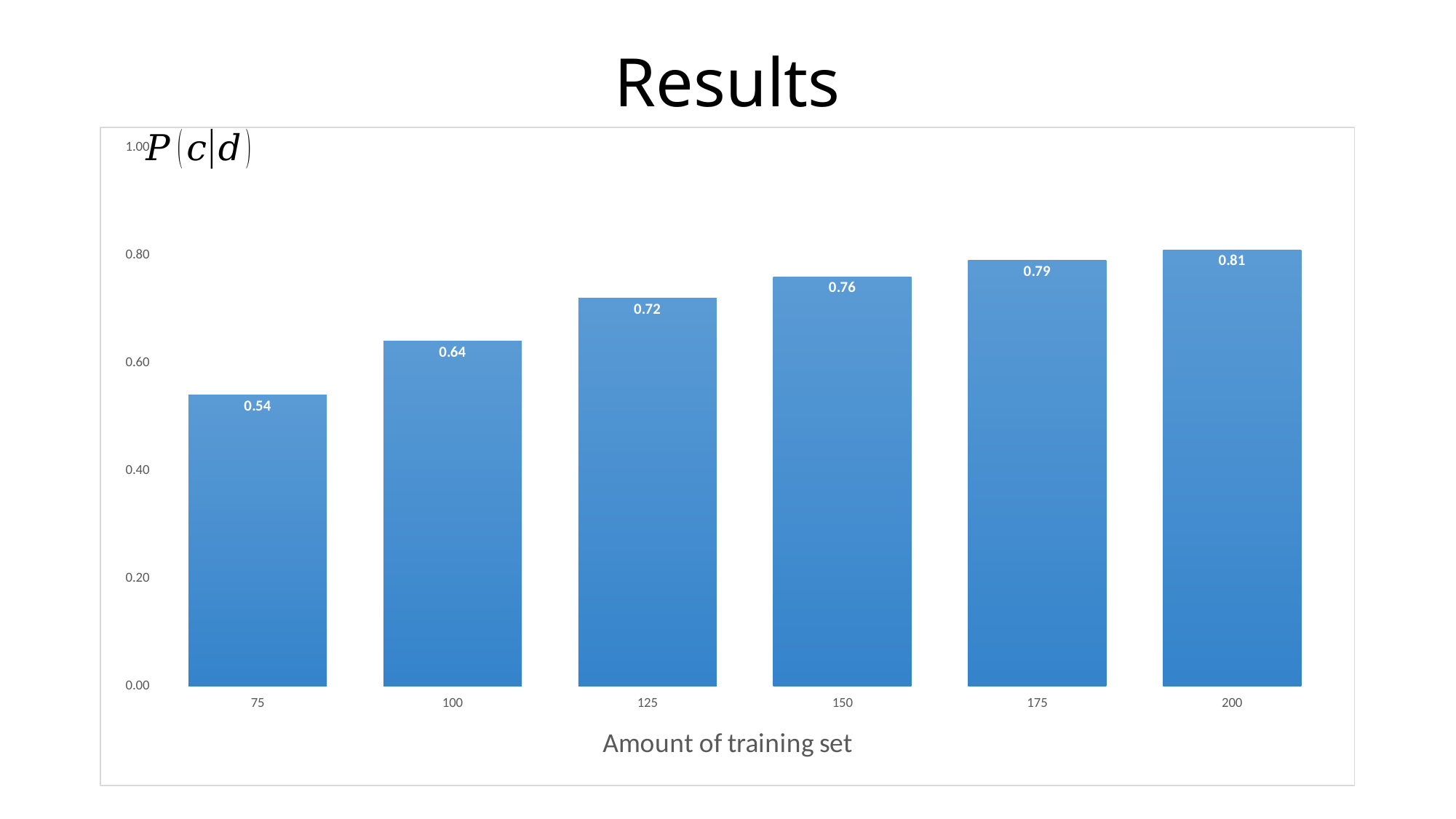
What is the value for a training set amount of 200? 0.81 Which has a larger value, a training set amount of 100 or 175? 175 How many training set amounts are shown on the x axis? 6 Do the values rise or fall as the amount of training set increases? rise What is the difference between the values for training set amounts 125 and 100? 0.08 Which training set amount has the highest value? 200 Which training set amount has the lowest value? 75 What is the value for a training set amount of 75? 0.54 What kind of chart is shown on the slide? bar chart What is the difference between the values for training set amounts 200 and 75? 0.27 Is the value for a training set amount of 125 greater or less than 0.60? greater What is the value for a training set amount of 150? 0.76